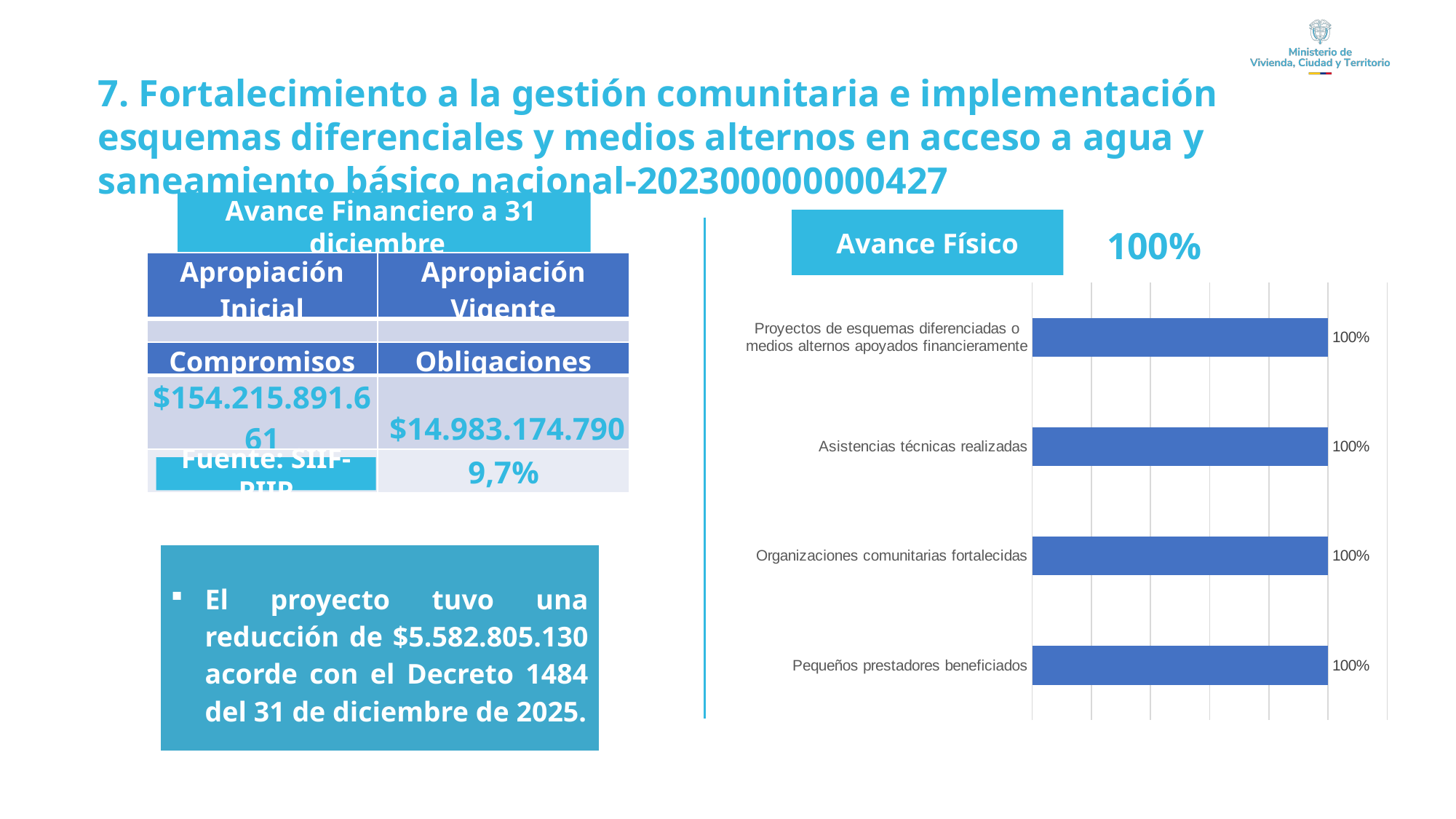
What is the value for Proyectos de esquemas diferenciadas o medios alternos apoyados financieramente in the Avance Físico chart? 100% What is the difference between the values for Asistencias técnicas realizadas and Pequeños prestadores beneficiados in the Avance Físico chart? 0% What kind of chart is the Avance Físico chart? Bar chart What is the value for Asistencias técnicas realizadas in the Avance Físico chart? 100% Which category is listed at the top of the Avance Físico chart? Proyectos de esquemas diferenciadas o medios alternos apoyados financieramente Do the values in the Avance Físico chart differ between categories, or are they all the same? All the same, 100% What is the value for Pequeños prestadores beneficiados in the Avance Físico chart? 100% What is the value for Organizaciones comunitarias fortalecidas in the Avance Físico chart? 100% Are the bars in the Avance Físico chart horizontal or vertical? Horizontal How many categories are shown in the Avance Físico chart? 4